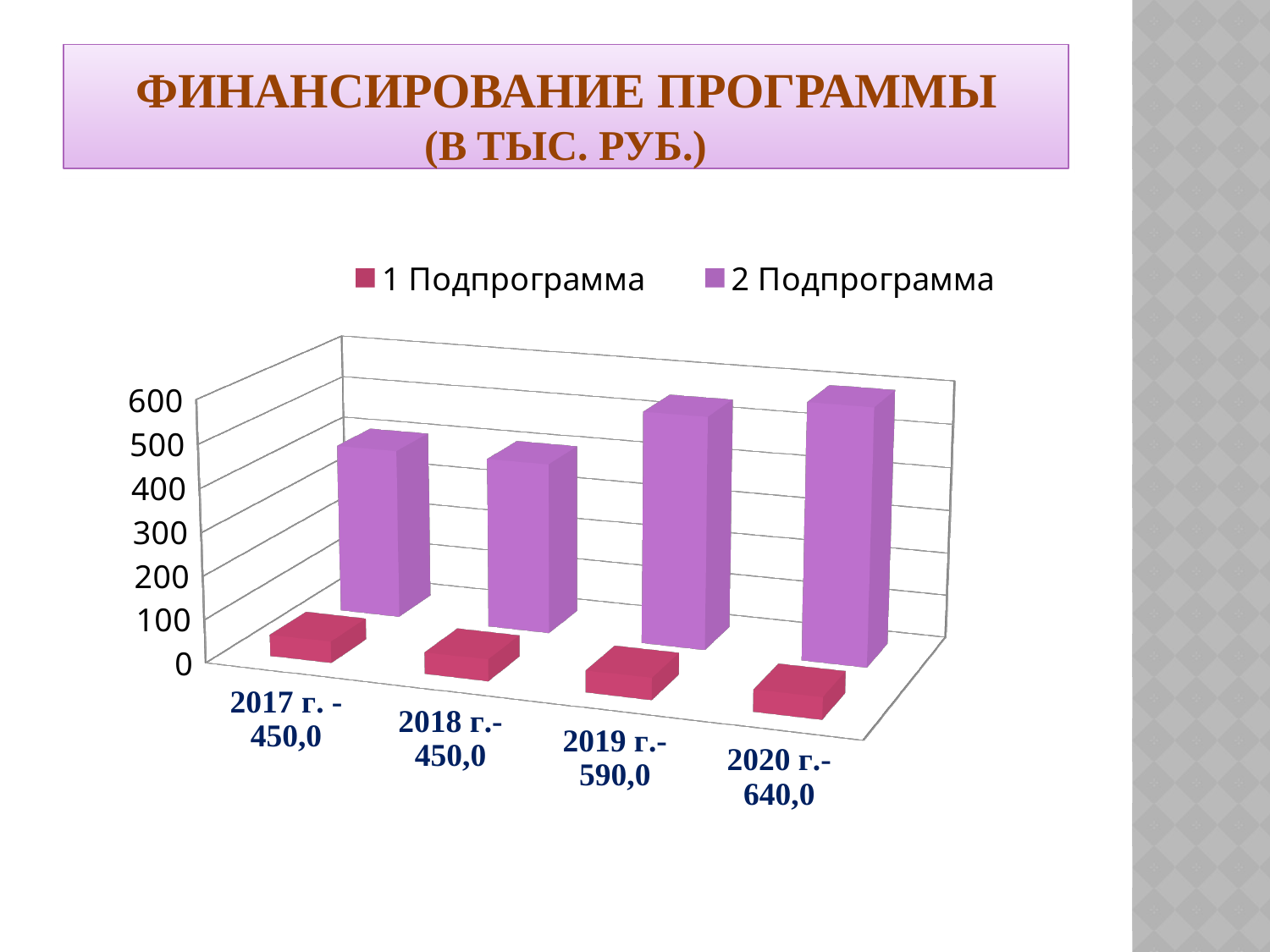
Is the value for 2 Подпрограмма in 2017 greater or less than 300? greater In 2019, which series has the larger value, 1 Подпрограмма or 2 Подпрограмма? 2 Подпрограмма Which year has the tallest bar for 2 Подпрограмма? 2020 What total amount is printed in the category label for 2017? 450,0 How many year categories are shown on the x axis? 4 What total amount is printed in the category label for 2020? 640,0 What kind of chart is shown on the slide? bar chart What total amount is printed in the category label for 2019? 590,0 Is the value for 1 Подпрограмма in 2017 greater or less than 100? less What is the title of the slide above the chart? ФИНАНСИРОВАНИЕ ПРОГРАММЫ (В ТЫС. РУБ.) What are the two series named in the legend? 1 Подпрограмма and 2 Подпрограмма How many series does the legend list? 2